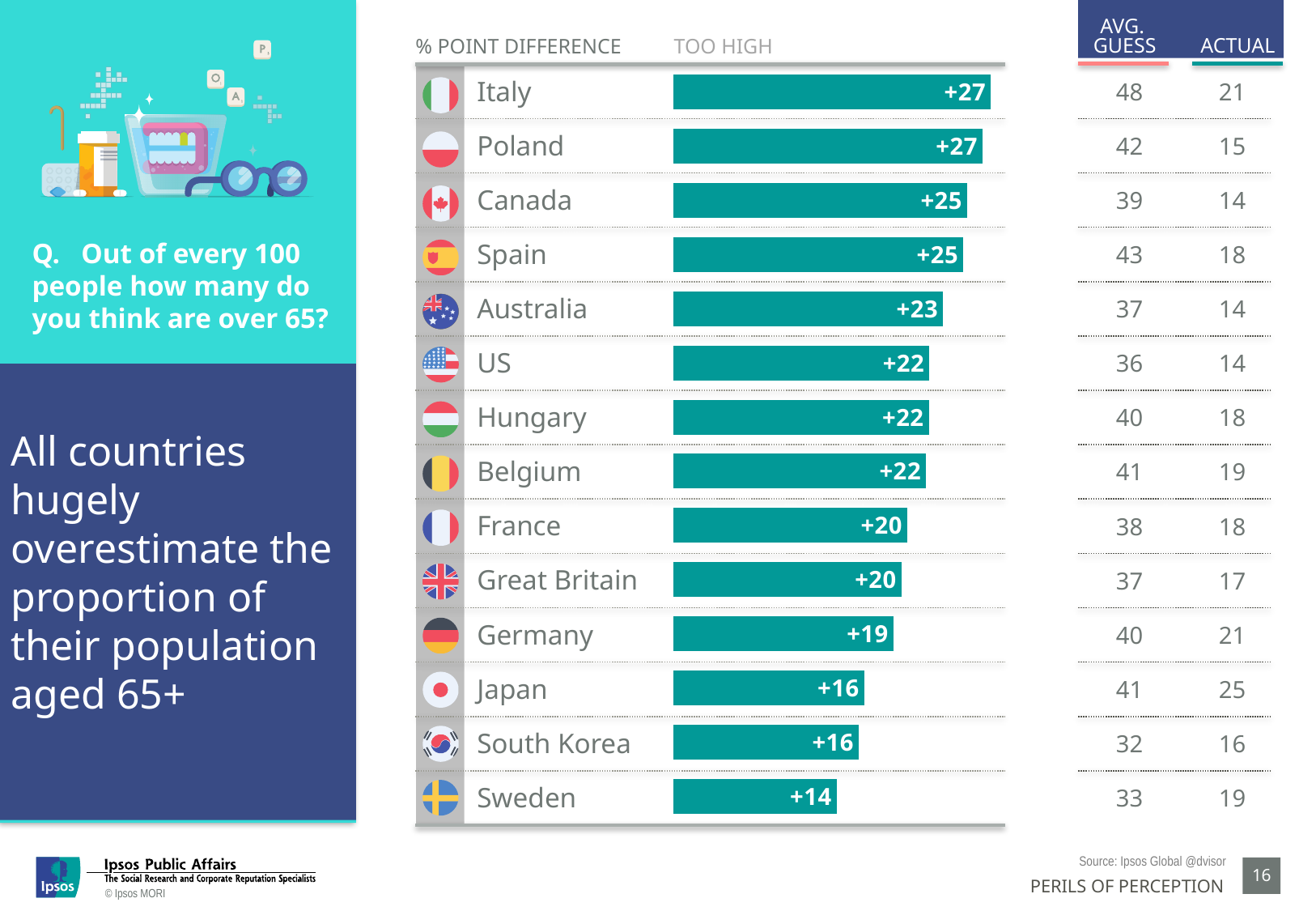
What is the % point difference shown for Italy? +27 What is the difference between the % point difference for Italy and for Sweden? 13 Which country has the lowest % point difference in the chart? Sweden What kind of chart is used to show the % point difference? Bar chart Which two countries share the highest % point difference of +27? Italy and Poland How many countries are listed in the chart? 14 What is the actual value for Japan in the table on the right? 25 What is the % point difference shown for Sweden? +14 What is the % point difference shown for Australia? +23 Do the % point difference values increase or decrease going down the list from Italy to Sweden? Decrease Which has a larger % point difference, Canada or Japan? Canada What is the average guess for Italy in the table on the right? 48